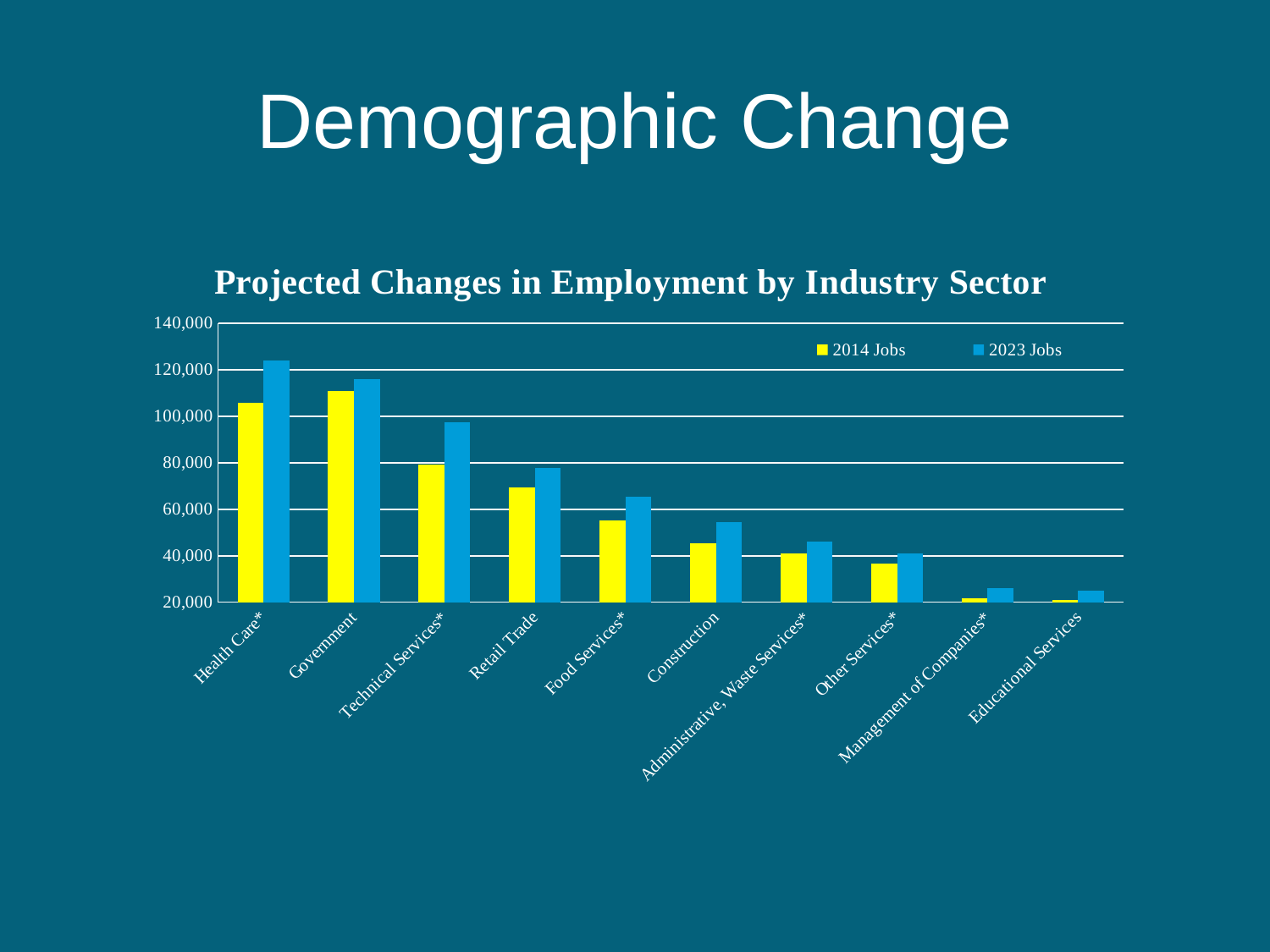
Do the 2023 Jobs values generally rise or fall moving from left to right along the x axis? fall Is the 2023 Jobs value for Management of Companies* greater or less than 40,000? less Is the 2023 Jobs value for Health Care* greater or less than 120,000? greater Which is larger for 2023 Jobs: Health Care* or Government? Health Care* What kind of chart is shown on the slide? bar chart Is the 2014 Jobs value for Retail Trade greater or less than 80,000? less How many industry sectors are shown on the x axis? 10 How many series does the legend list? 2 Which is larger for 2023 Jobs: Retail Trade or Food Services*? Retail Trade What is the title of the chart? Projected Changes in Employment by Industry Sector Which industry sector has the highest value for 2023 Jobs? Health Care*